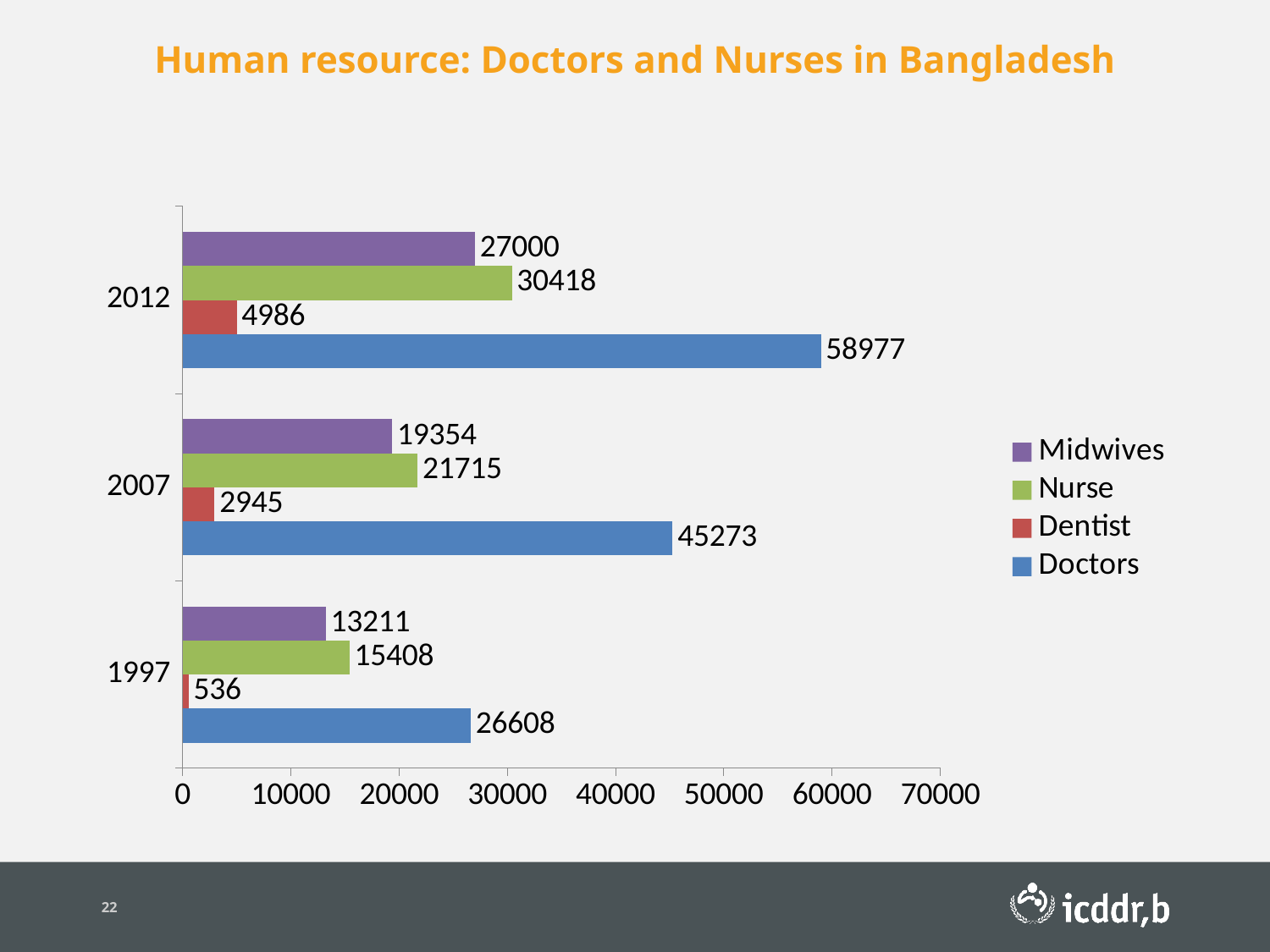
What is the difference between the number of Doctors in 2012 and in 2007? 13704 Which year has the highest number of Doctors? 2012 What is the number of Midwives in 2012? 27000 What is the number of Dentists in 1997? 536 What is the title of the chart? Human resource: Doctors and Nurses in Bangladesh What is the number of Nurses in 2007? 21715 Does the number of Dentists rise or fall from 1997 to 2012? Rise Which is larger in 2007: the number of Nurses or the number of Midwives? Nurses How many series does the legend list? 4 What is the number of Doctors in 2012? 58977 What kind of chart is shown on the slide? Bar chart Which year has the lowest number of Midwives? 1997